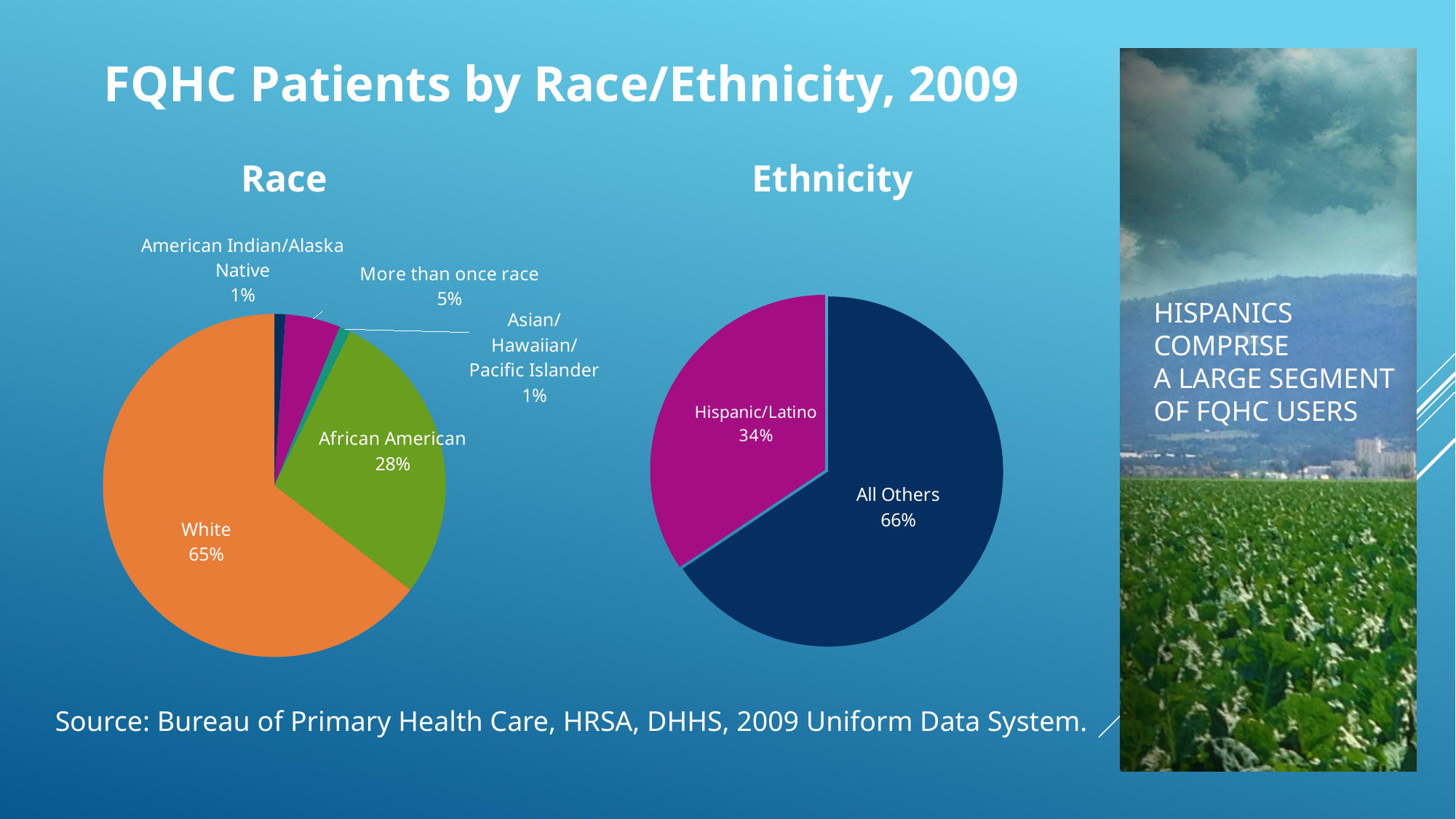
What type of chart is used for the Ethnicity data? Pie chart In the Race pie chart, what share of FQHC patients is White? 65% In the Ethnicity pie chart, what share of FQHC patients is Hispanic/Latino? 34% In the Ethnicity pie chart, what share is All Others? 66% In the Race pie chart, which is larger: African American or More than once race? African American In the Race pie chart, what share of FQHC patients is African American? 28% In the Ethnicity pie chart, which category has the smaller slice? Hispanic/Latino In the Race pie chart, what share is labelled 'More than once race'? 5% In the Race pie chart, which category has the largest slice? White What is the title of the slide containing the two pie charts? FQHC Patients by Race/Ethnicity, 2009 In the Race pie chart, how many slices (categories) are shown? 5 In the Race pie chart, what is the difference in percentage points between White and African American? 37